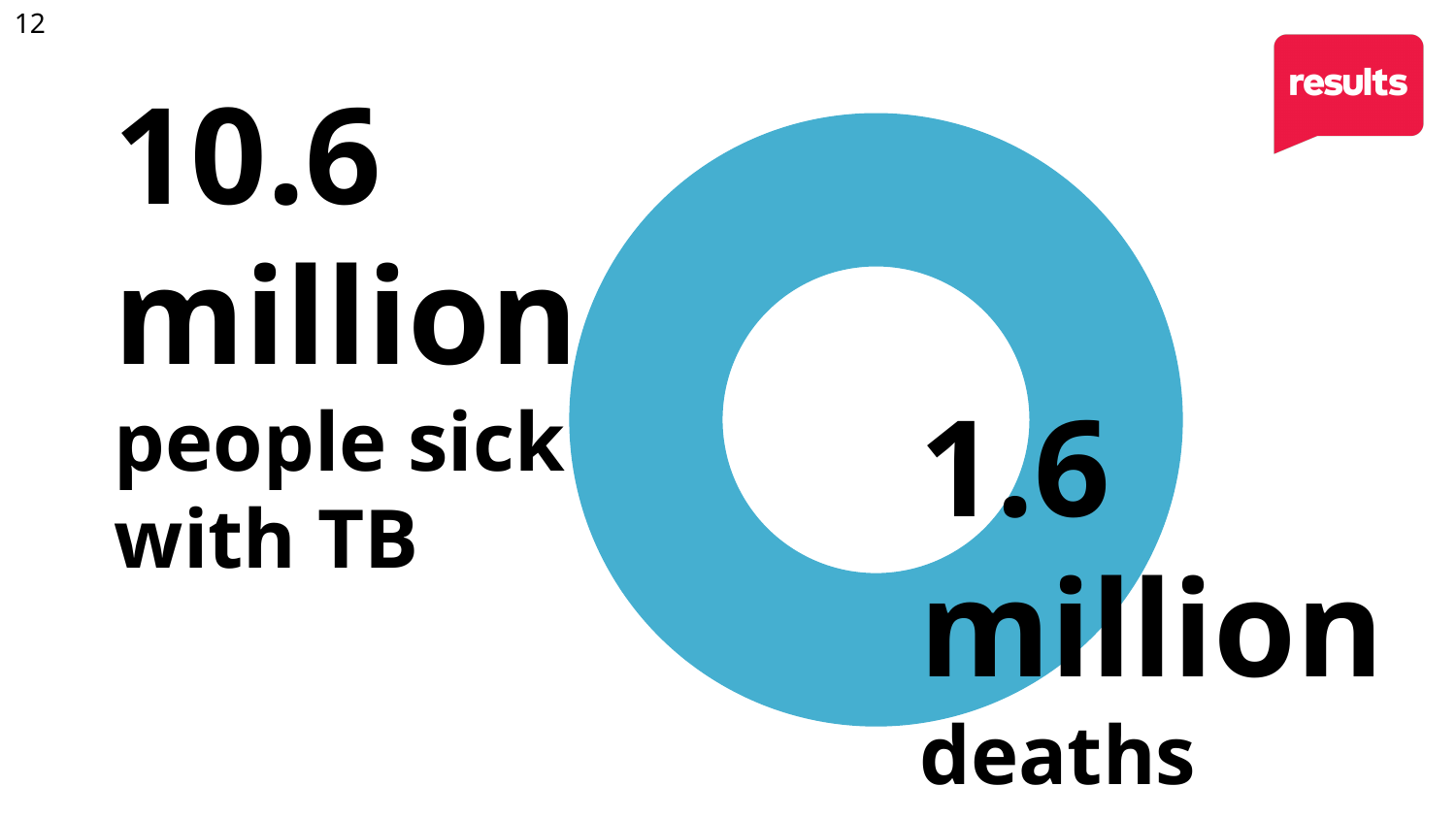
Which figure is larger, the number of people sick with TB or the number of deaths? people sick with TB What colour is the ring of the doughnut chart? blue How many differently coloured segments are visible in the doughnut chart? 1 Does the doughnut chart have a legend? no Is the number of deaths greater or less than 2 million? less How many deaths are stated on the slide next to the doughnut chart? 1.6 million Is the number of people sick with TB greater or less than 10 million? greater How many people are stated to be sick with TB on the slide? 10.6 million What kind of chart is shown on the slide? doughnut chart